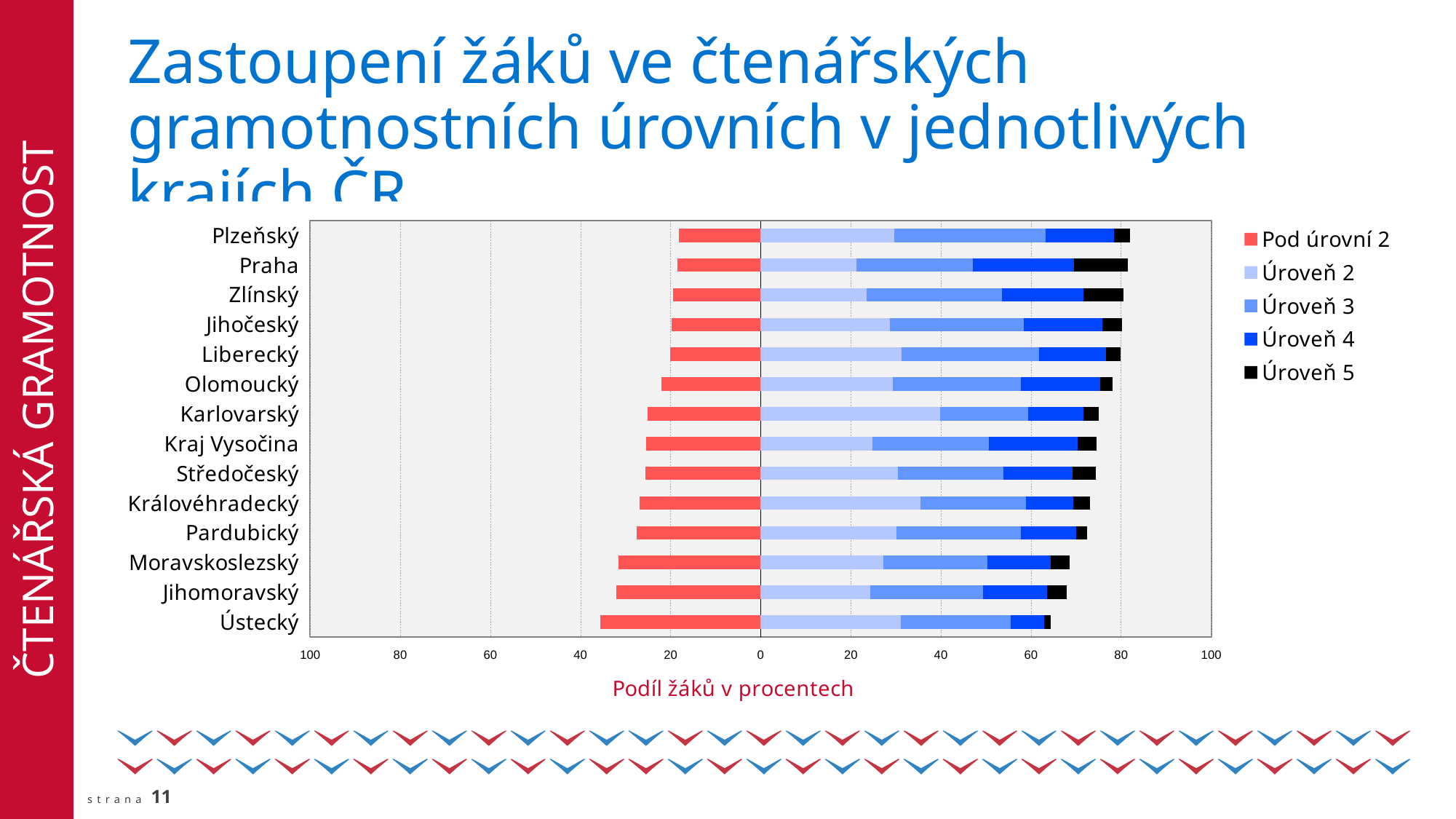
Is the combined value of levels 2 to 5 (the bars to the right of zero) for Ústecký greater or less than 80? less Which region is listed at the bottom of the chart? Ústecký How many regions (categories) are listed on the vertical axis of the chart? 14 Is the 'Pod úrovní 2' value for Ústecký greater or less than 20? greater Going from the top region to the bottom region, do the red 'Pod úrovní 2' bars get longer or shorter? longer How many series does the chart legend list? 5 Is the 'Pod úrovní 2' value for Moravskoslezský greater or less than 20? greater What kind of chart is shown on the slide? Stacked bar chart Which region has the largest share of pupils in the 'Pod úrovní 2' category? Ústecký Which region has a larger 'Pod úrovní 2' value, Ústecký or Plzeňský? Ústecký Which region is listed at the top of the chart? Plzeňský